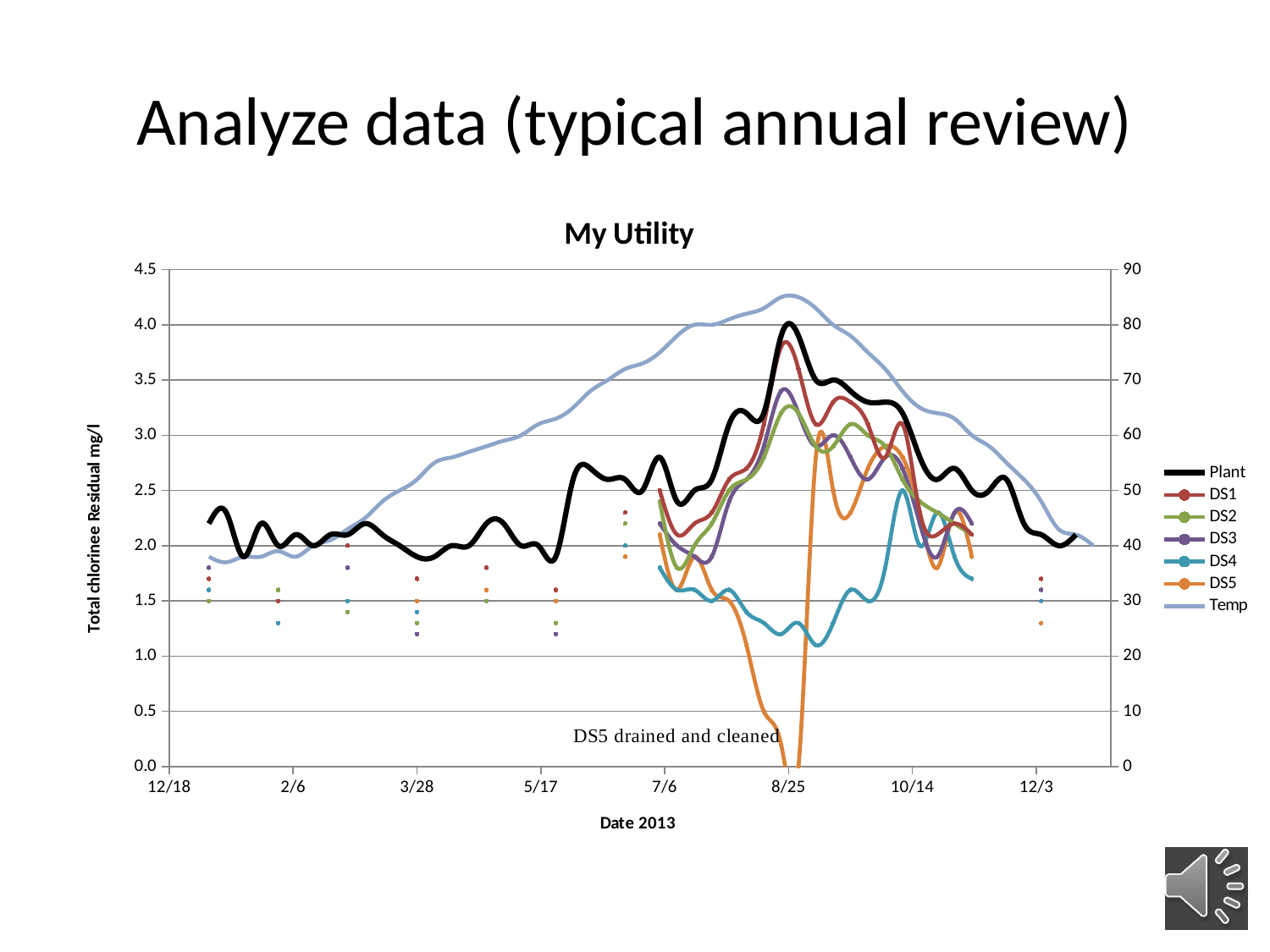
Which series drops to 0.0 around 8/25? DS5 Is the peak value of the Temp series (right axis) greater or less than 80? greater Is the lowest value of the DS4 series greater or less than 1.5? less Which series reaches the highest value on the left axis around 8/25, Plant or DS4? Plant What kind of chart is shown on the slide? line chart What is the title of the chart? My Utility Does the Temp series rise or fall between 2/6 and 8/25? rise Does the Temp series rise or fall between 8/25 and 12/3? fall How many series does the legend list? 7 What is the label of the left vertical axis? Total chlorinee Residual mg/l Is the peak value of the Plant series near 8/25 greater or less than 3.5? greater